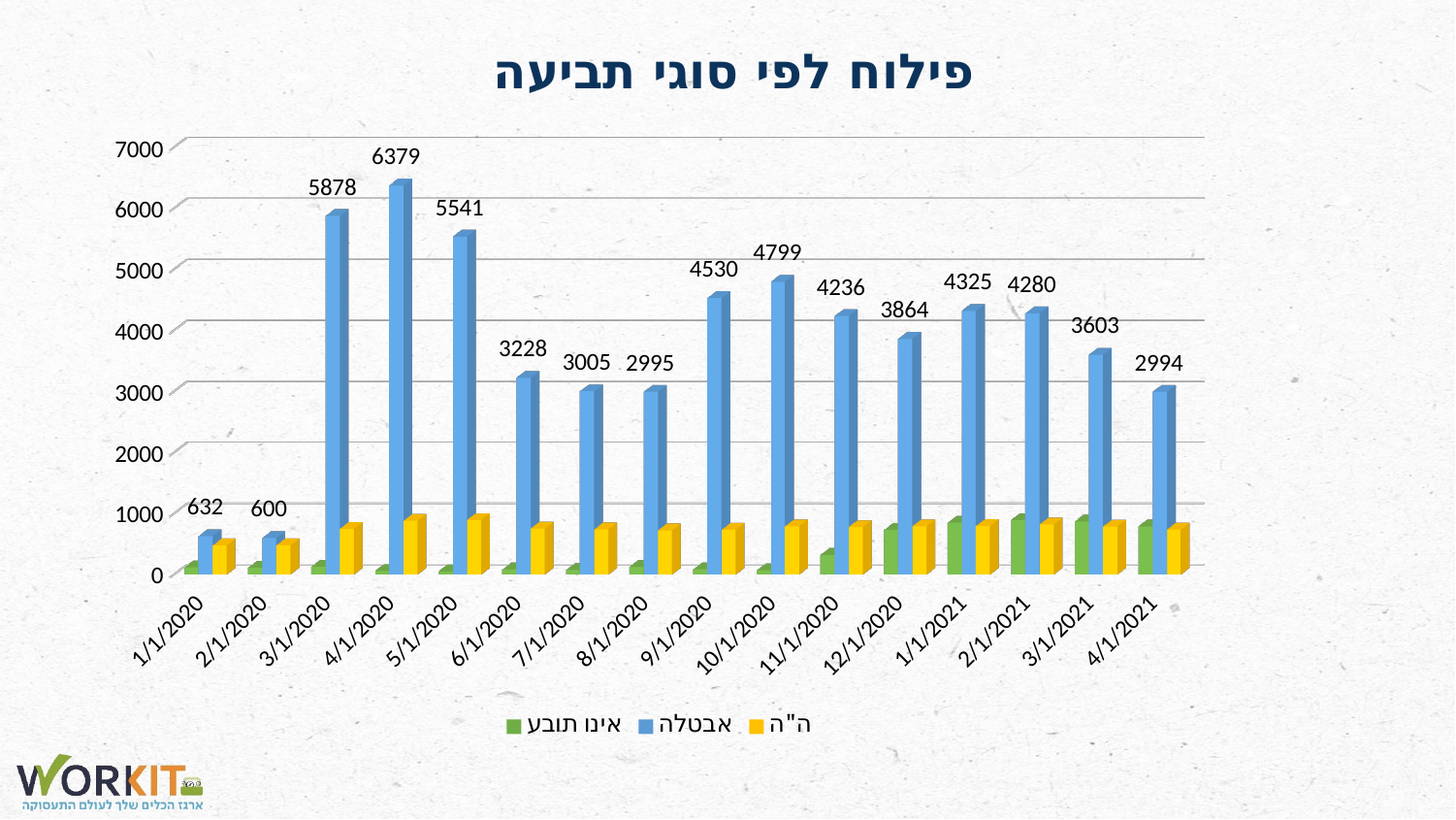
Which is larger, the אבטלה value for 9/1/2020 or for 10/1/2020? 10/1/2020 What is the difference between the אבטלה values for 3/1/2020 and 5/1/2020? 337 What is the title of the chart? פילוח לפי סוגי תביעה What is the value of the אבטלה series for 4/1/2020? 6379 What is the value of the אבטלה series for 1/1/2020? 632 What kind of chart is shown on the slide? Bar chart Is the value of the ה"ה series for 4/1/2020 greater or less than 2000? less How many dates are shown on the x axis? 16 Which date has the lowest value for the אבטלה series? 2/1/2020 What is the value of the אבטלה series for 3/1/2021? 3603 Which date has the highest value for the אבטלה series? 4/1/2020 How many series does the legend list? 3